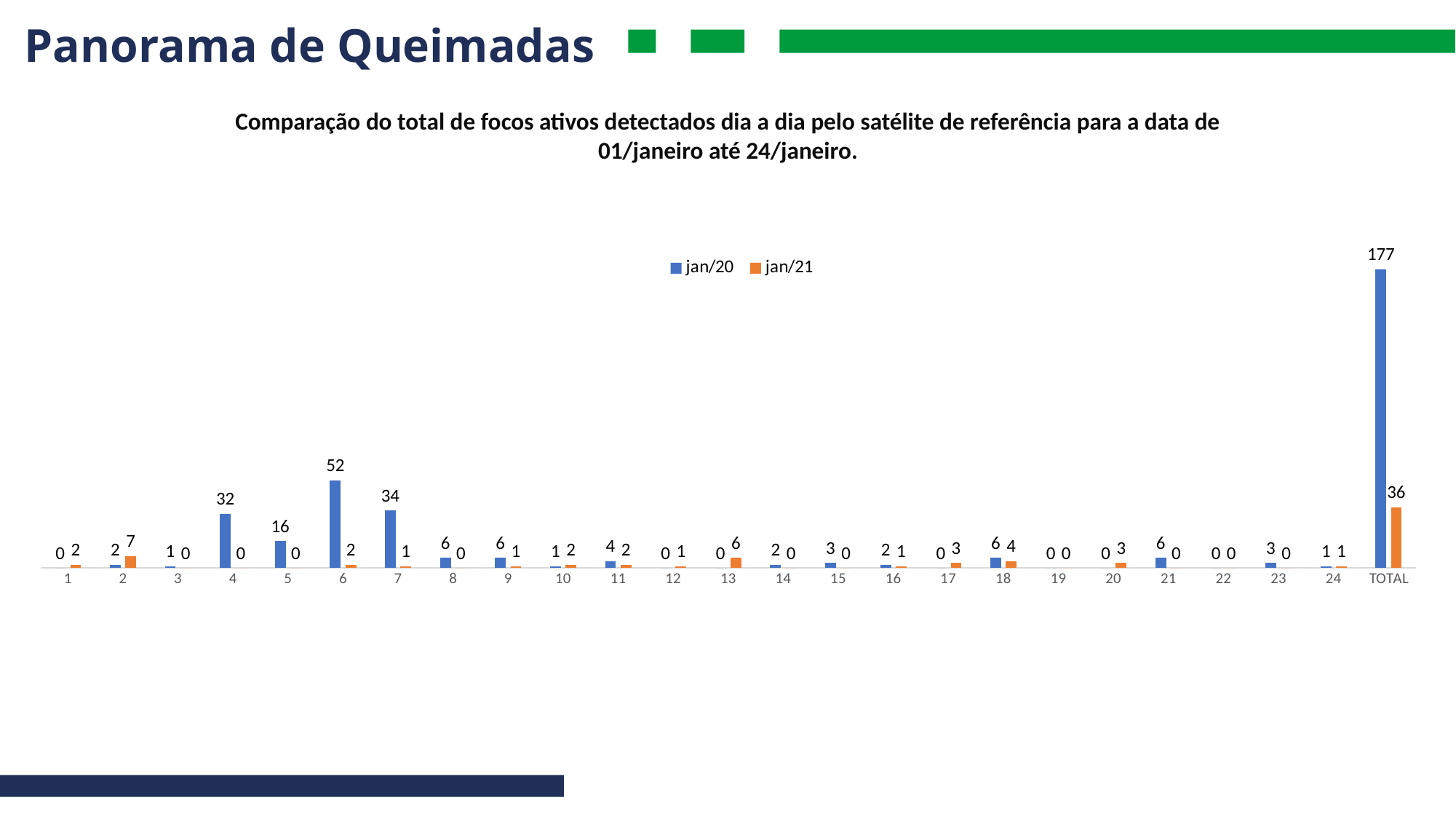
What is the jan/20 value for TOTAL? 177 What is the difference between the jan/20 and jan/21 values for TOTAL? 141 Among days 1 to 24, which day has the highest jan/20 value? 6 What is the jan/21 value for TOTAL? 36 Which colour represents the jan/21 series? orange Which is larger on day 13, the jan/20 value or the jan/21 value? jan/21 What is the jan/21 value for day 2? 7 What kind of chart is shown on the slide? bar chart What is the difference between the jan/20 values for day 6 and day 7? 18 Among days 1 to 24, which day has the highest jan/21 value? 2 What is the jan/20 value for day 6? 52 How many series does the legend list? 2